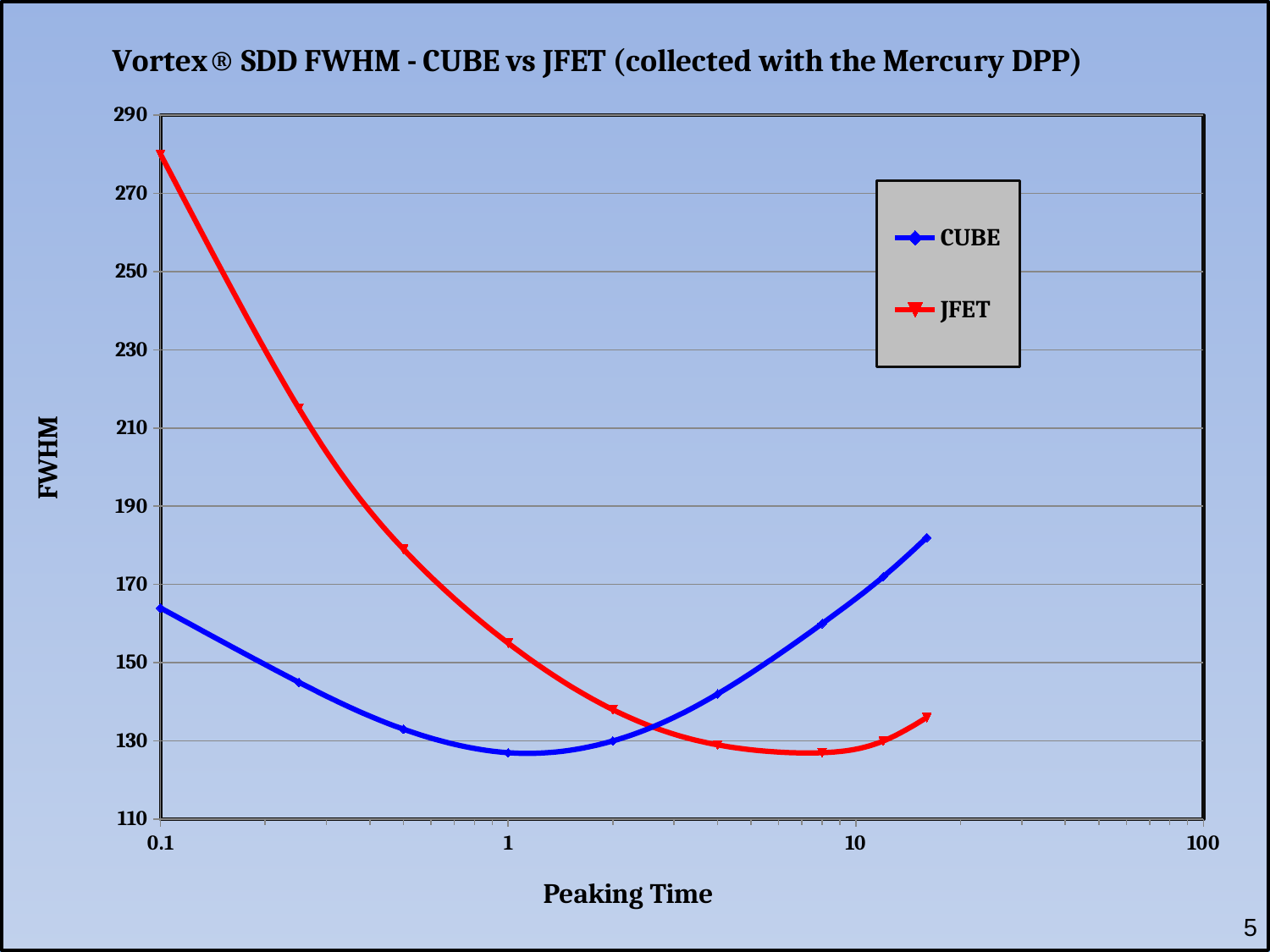
Is the JFET value at a peaking time of 1 greater or less than 130? greater Does the CUBE series rise or fall as peaking time increases from 1 to 10? rise Is the JFET value at a peaking time of 0.1 greater or less than 270? greater Is the CUBE value at a peaking time of 1 greater or less than 150? less Does the JFET series rise or fall as peaking time increases from 0.1 to 1? fall How many series does the legend list? 2 At a peaking time of 0.1, which series has the higher FWHM, CUBE or JFET? JFET What is the label of the x axis? Peaking Time What kind of chart is shown on the slide? line chart At a peaking time of 10, which series has the higher FWHM, CUBE or JFET? CUBE What is the title of the chart? Vortex® SDD FWHM - CUBE vs JFET (collected with the Mercury DPP)